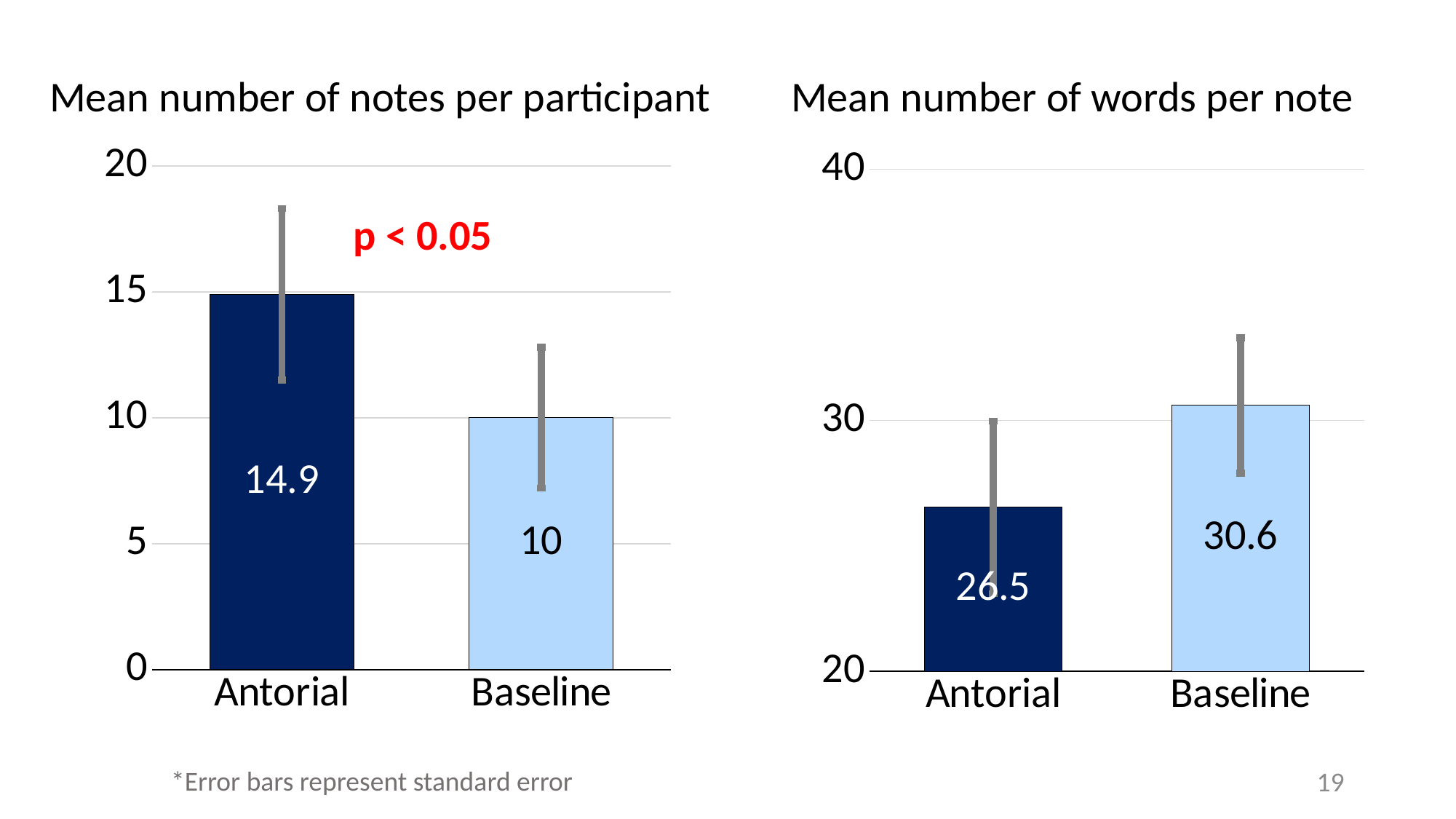
In the 'Mean number of notes per participant' chart, which category has the highest value? Antorial In the 'Mean number of words per note' chart, which category has the lowest value? Antorial How many categories are shown in the 'Mean number of notes per participant' chart? 2 In the 'Mean number of words per note' chart, what is the difference between the Baseline and Antorial values? 4.1 In the 'Mean number of words per note' chart, which is larger, Antorial or Baseline? Baseline In the 'Mean number of words per note' chart, what is the value for Baseline? 30.6 In the 'Mean number of words per note' chart, what is the value for Antorial? 26.5 What kind of chart is the 'Mean number of words per note' chart? Bar chart In the 'Mean number of notes per participant' chart, what is the difference between the Antorial and Baseline values? 4.9 In the 'Mean number of notes per participant' chart, what is the value for Antorial? 14.9 According to the footnote on the slide, what do the error bars represent? Standard error In the 'Mean number of notes per participant' chart, what is the value for Baseline? 10